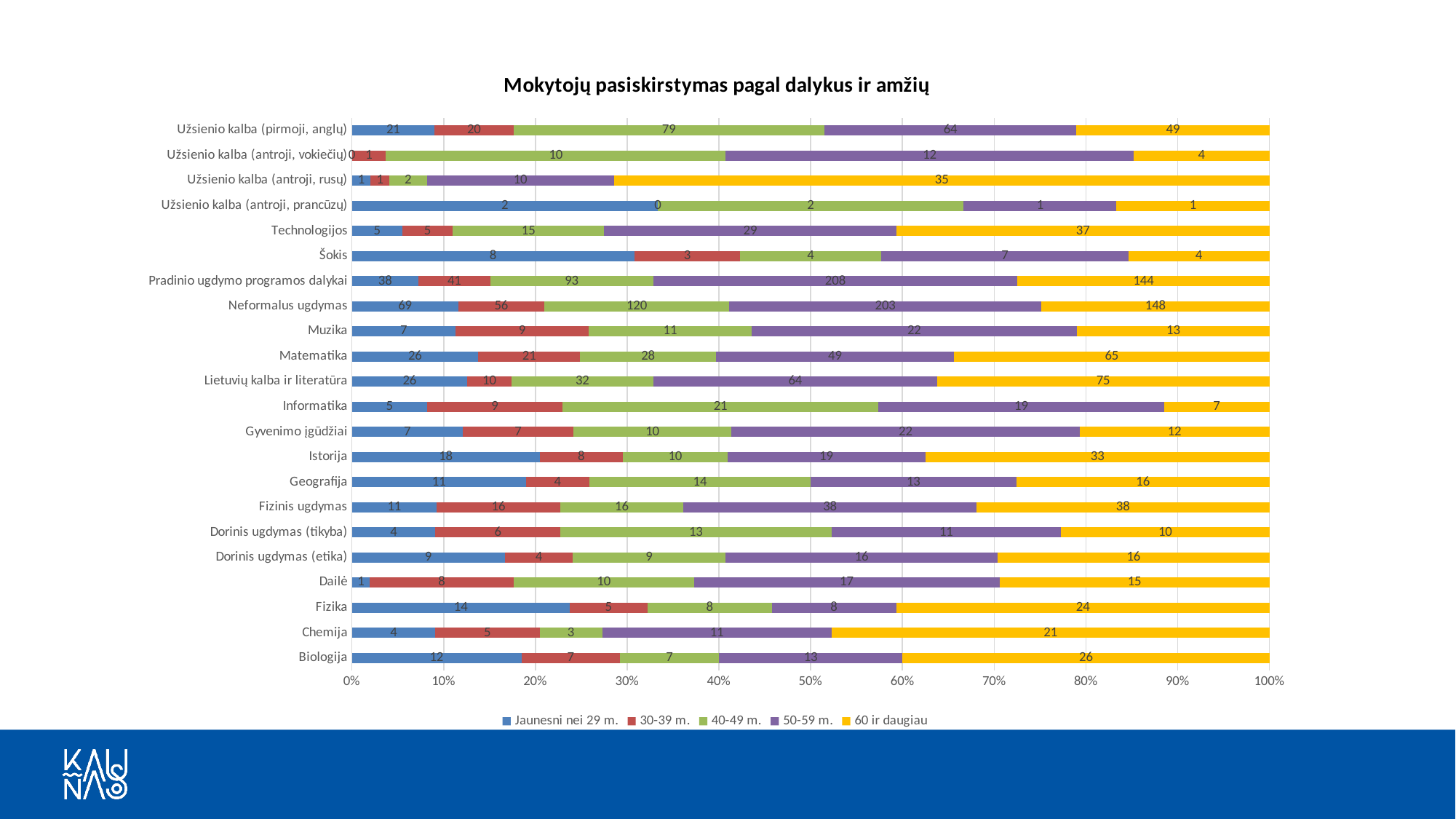
What is the value for the '60 ir daugiau' series for Matematika? 65 For Užsienio kalba (pirmoji, anglų), what is the difference between the '40-49 m.' value and the '30-39 m.' value? 59 What is the total of all age groups for Fizika? 59 What is the value for the '50-59 m.' series for Neformalus ugdymas? 203 What is the total of all age groups for Biologija? 65 What is the title of the chart? Mokytojų pasiskirstymas pagal dalykus ir amžių What is the value for the '40-49 m.' series for Pradinio ugdymo programos dalykai? 93 For Istorija, which is larger: the '60 ir daugiau' value or the 'Jaunesni nei 29 m.' value? 60 ir daugiau For Technologijos, which age group has the highest value? 60 ir daugiau How many subject categories are shown on the vertical axis? 22 What kind of chart is shown on the slide? Stacked bar chart How many series does the legend list? 5